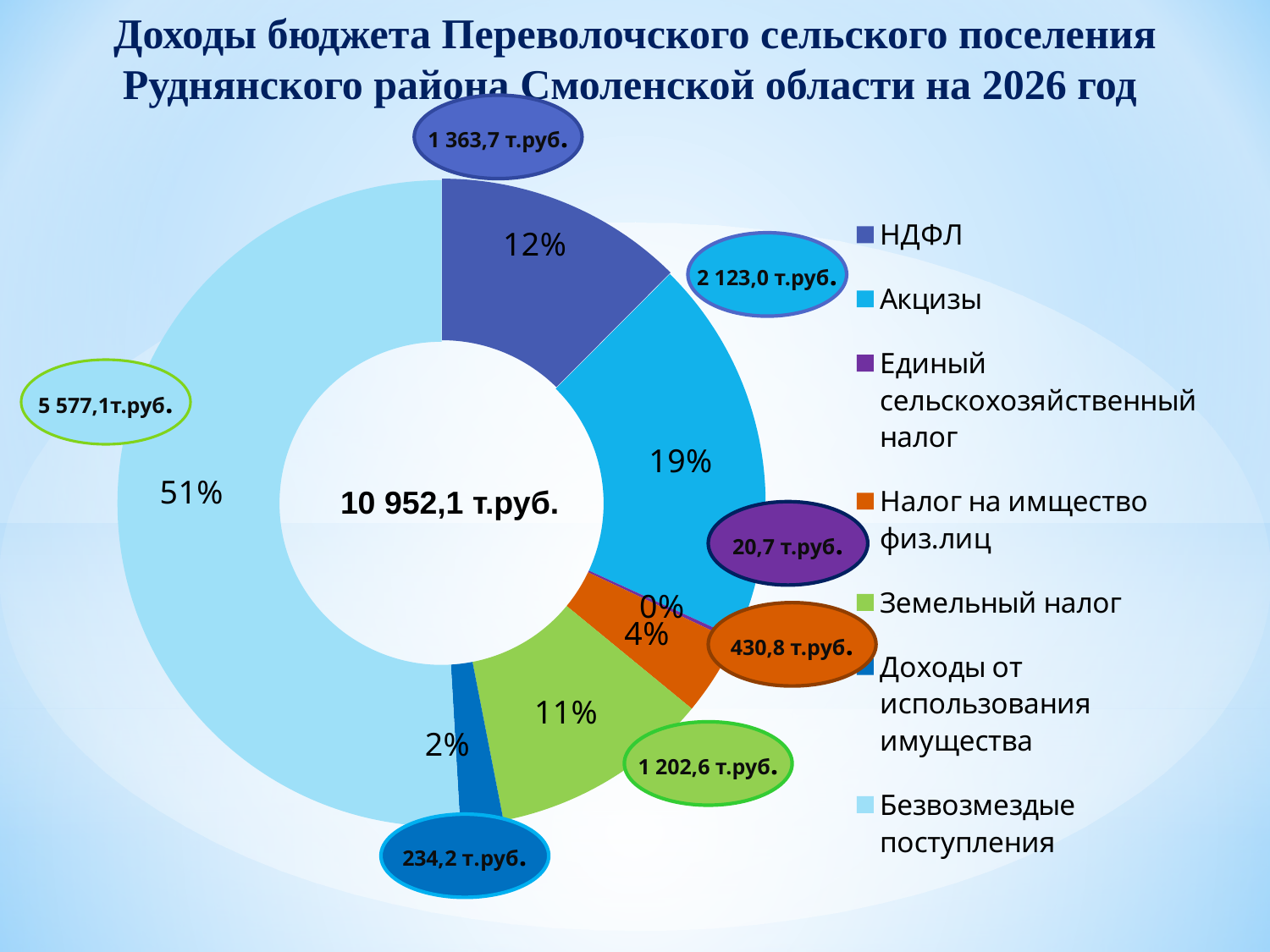
What value is shown in the callout for Земельный налог? 1 202,6 т.руб. Which is larger: the share for Акцизы or the share for НДФЛ? Акцизы What value is shown in the callout for Единый сельскохозяйственный налог? 20,7 т.руб. What percentage is shown for Акцизы? 19% What share of the chart does Безвозмездые поступления account for? 51% What kind of chart is shown on the slide? doughnut chart Which category has the smallest share of the chart? Единый сельскохозяйственный налог How many categories does the legend list? 7 What value is shown in the callout for НДФЛ? 1 363,7 т.руб. Which category has the largest share of the chart? Безвозмездые поступления What is the difference in percentage points between the share for Акцизы and the share for Земельный налог? 8 What total value is printed in the centre of the chart? 10 952,1 т.руб.